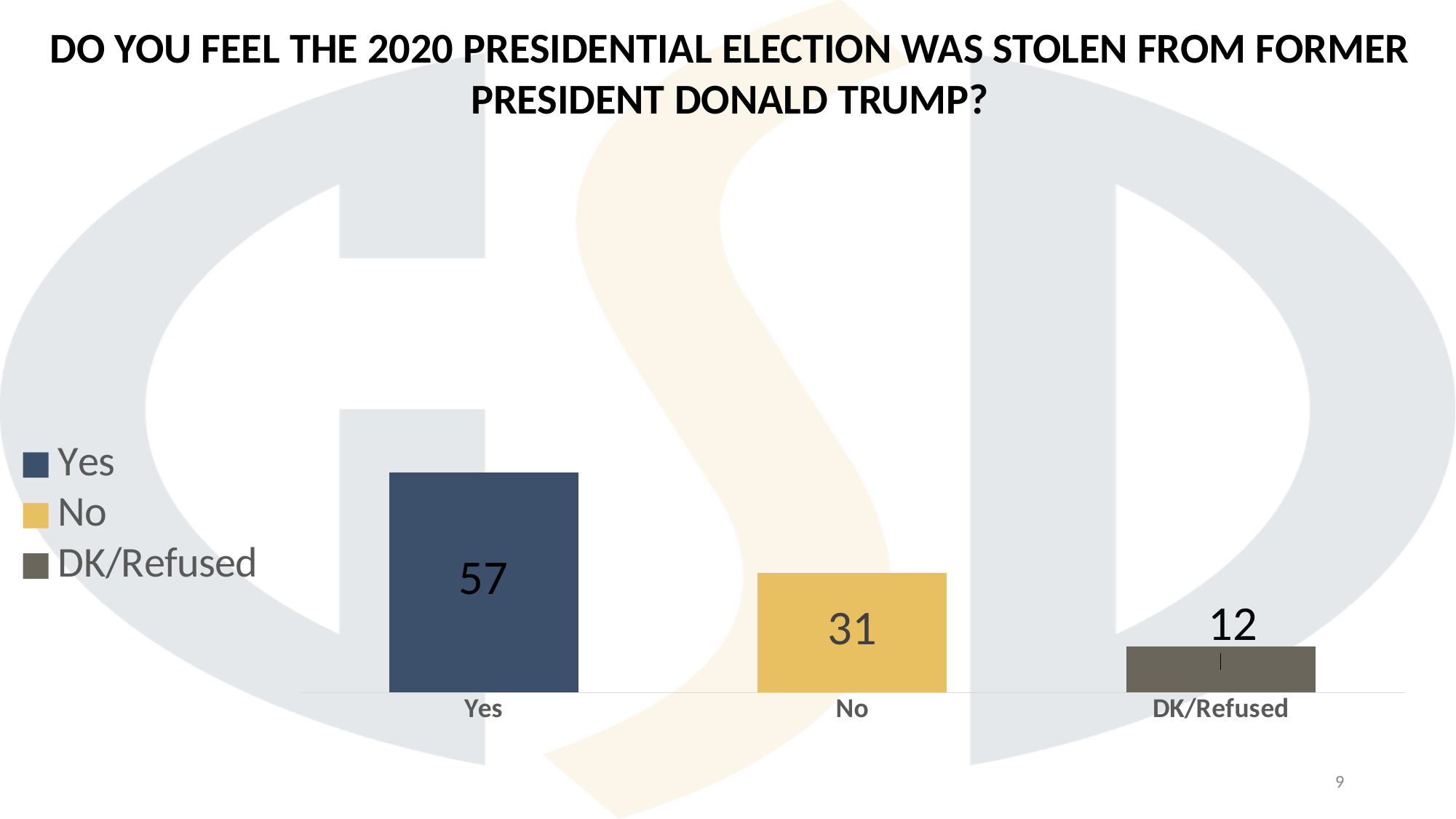
How many categories are shown on the x axis? 3 Which category has the lowest value? DK/Refused How many entries does the legend list? 3 What is the value for Yes? 57 What is the value for DK/Refused? 12 Which is larger, the value for Yes or the value for No? Yes Which category has the highest value? Yes What kind of chart is shown on the slide? Bar chart What is the difference between the values for No and DK/Refused? 19 What is the difference between the values for Yes and No? 26 What is the value for No? 31 What colour is the bar for No? Yellow